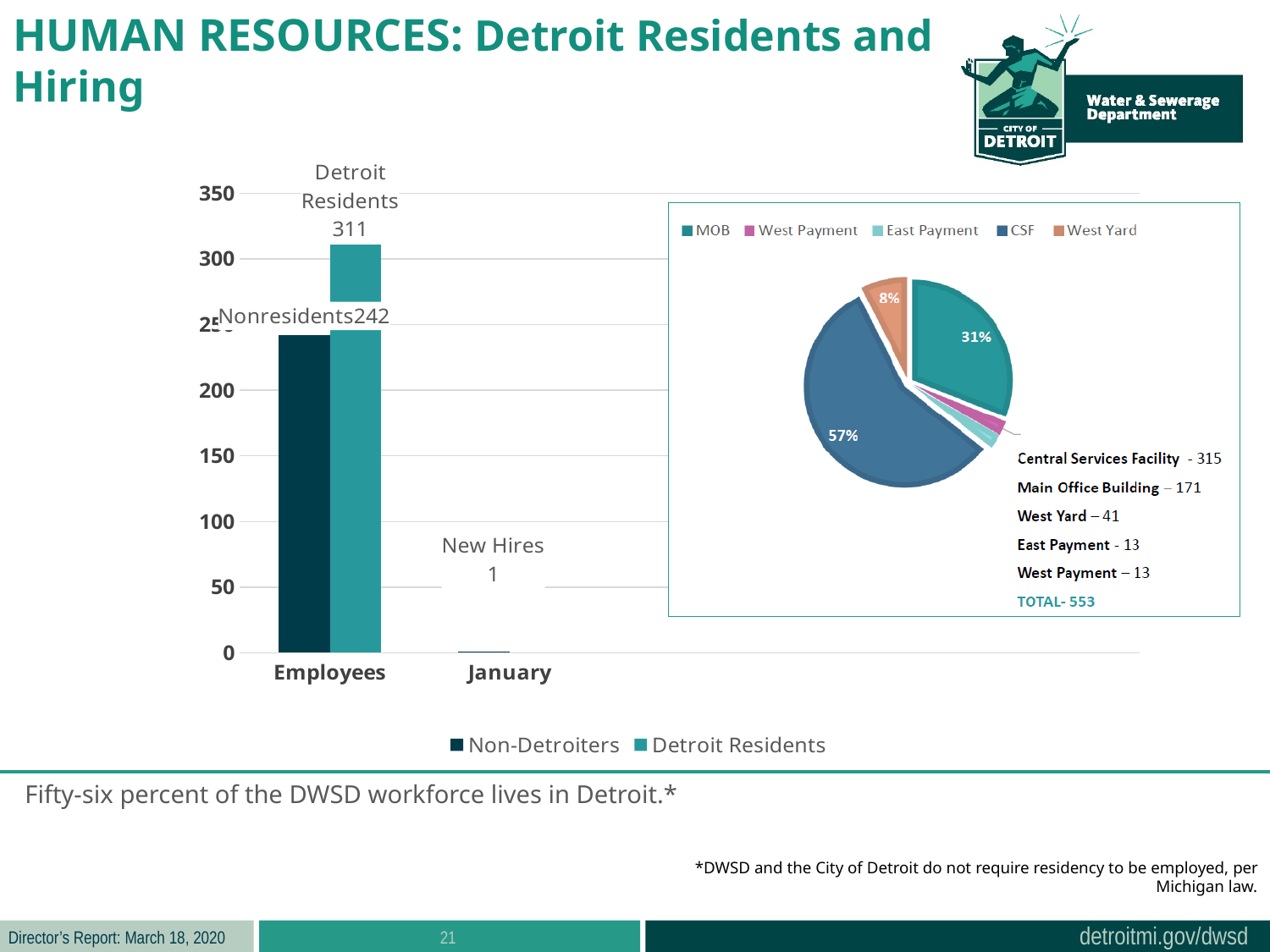
In the bar chart on the left, what is the difference between Detroit Residents (311) and Nonresidents (242) among Employees? 69 In the bar chart on the left, how many New Hires are shown for January? 1 In the bar chart on the left, which is larger among Employees: Detroit Residents or Non-Detroiters? Detroit Residents In the pie chart on the right, what percentage share does CSF have? 57% In the pie chart on the right, how many categories does the legend list? 5 In the bar chart on the left, what is the value for Nonresidents among Employees? 242 In the pie chart on the right, what percentage share does MOB have? 31% In the bar chart on the left, what is the value for Detroit Residents among Employees? 311 In the bar chart on the left, how many series does the legend list? 2 What kind of chart is the chart on the left of the slide? Bar chart In the pie chart on the right, what percentage share does West Yard have? 8% In the pie chart on the right, which location has the largest share? CSF